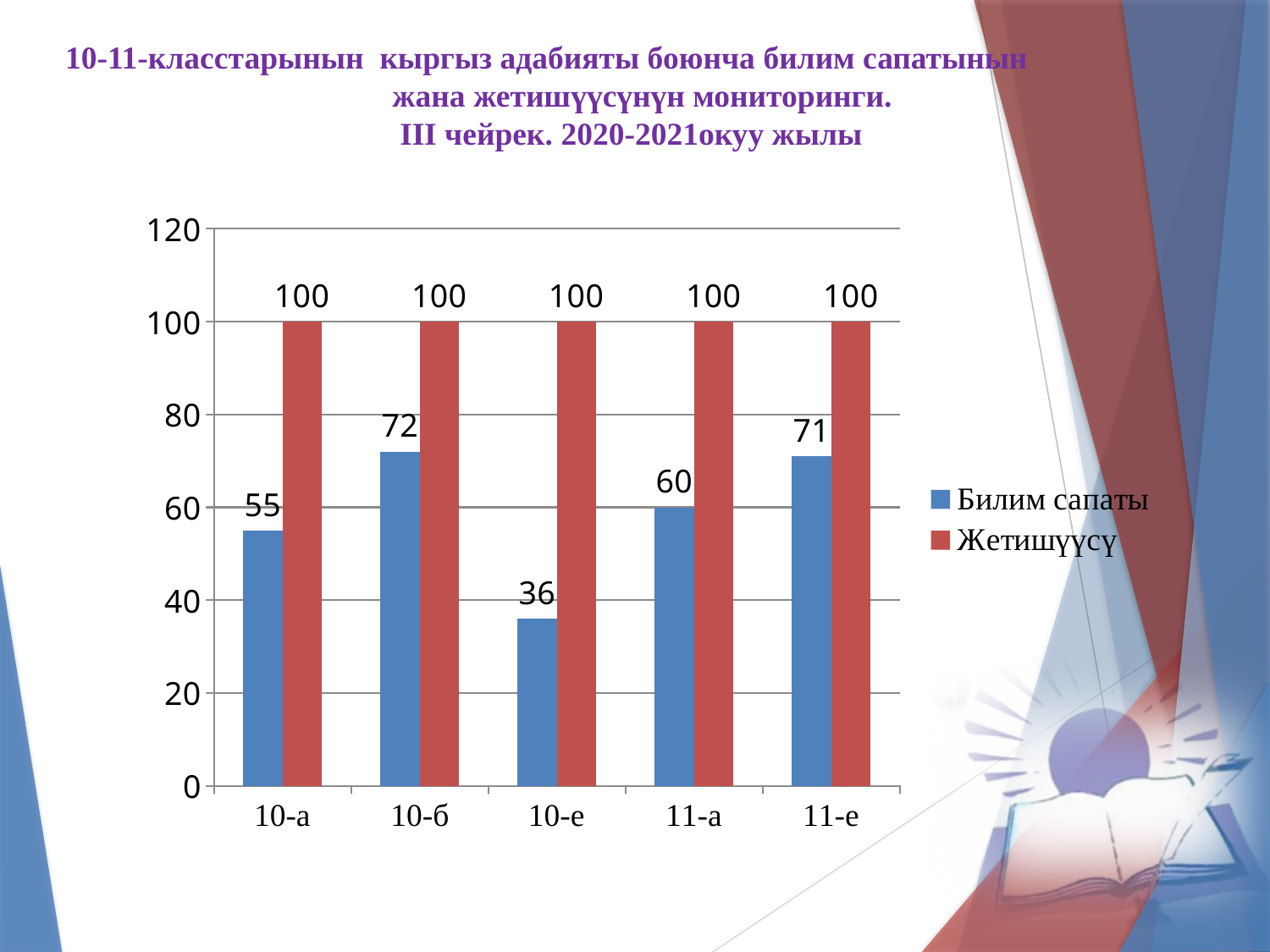
Which is larger, the Билим сапаты value for 11-а or for 11-е? 11-е Which class has the lowest Билим сапаты value? 10-е What is the difference between the Билим сапаты values for 10-б and 10-е? 36 What is the Жетишүүсү value for 11-а? 100 Which class has the highest Билим сапаты value? 10-б How many classes are shown on the x axis? 5 What colour are the Жетишүүсү bars? red What kind of chart is shown on the slide? bar chart How many series does the legend list? 2 What is the Билим сапаты value for 10-е? 36 Is the Билим сапаты value for 10-а greater or less than 60? less What is the Билим сапаты value for 10-б? 72